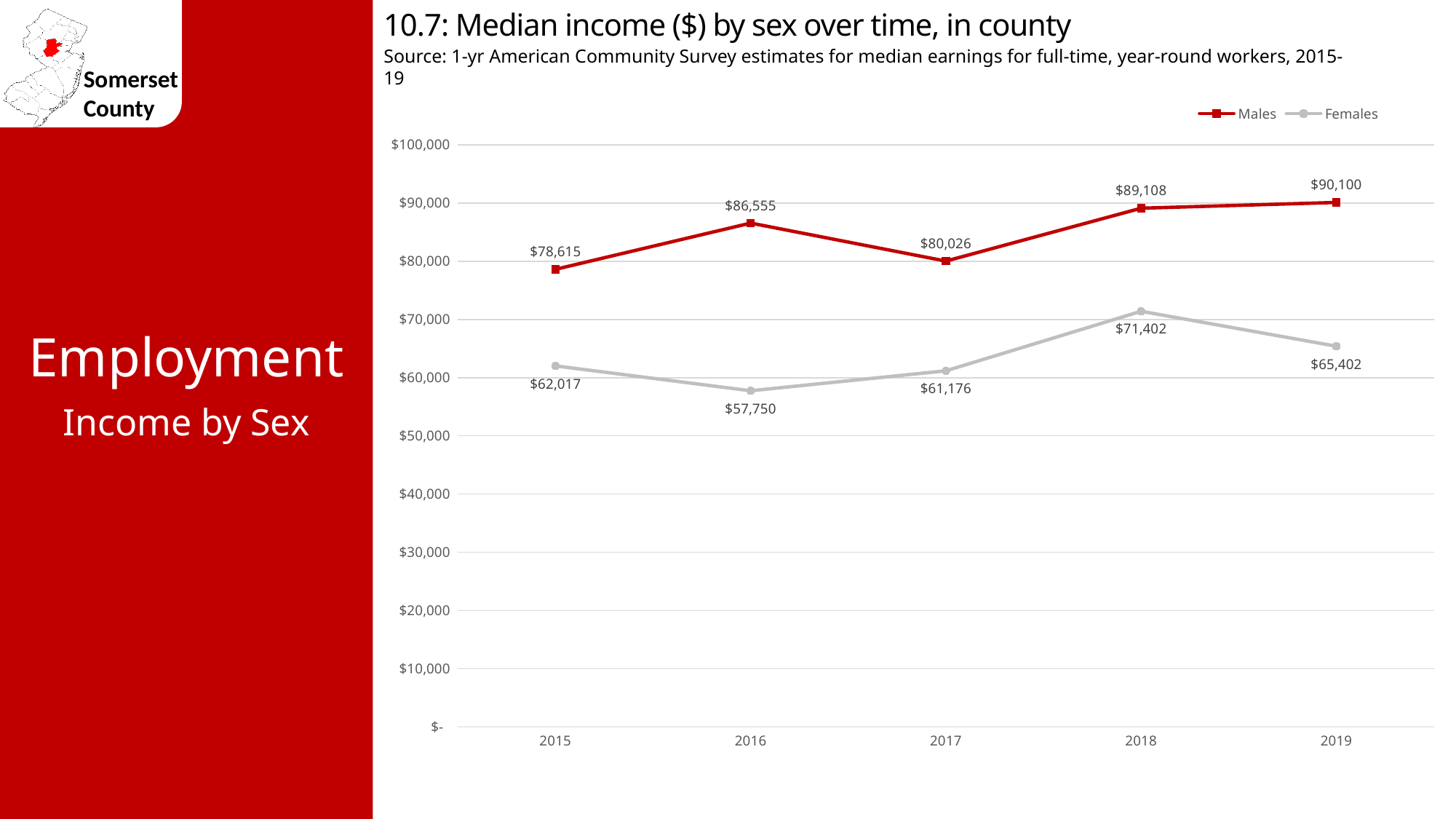
What was the median income for Males in 2016? $86,555 In which year was the median income for Females lowest? 2016 What kind of chart is shown on the slide? line chart Did the median income for Males rise or fall from 2017 to 2019? rise What was the median income for Females in 2018? $71,402 In which year was the median income for Males highest? 2019 How many years are plotted on the x axis? 5 What is the difference between the Males and Females median income in 2019? $24,698 How many series does the legend list? 2 Is the median income for Females in 2019 greater or less than $70,000? less What was the median income for Females in 2015? $62,017 Which was larger in 2017: the median income for Males or for Females? Males